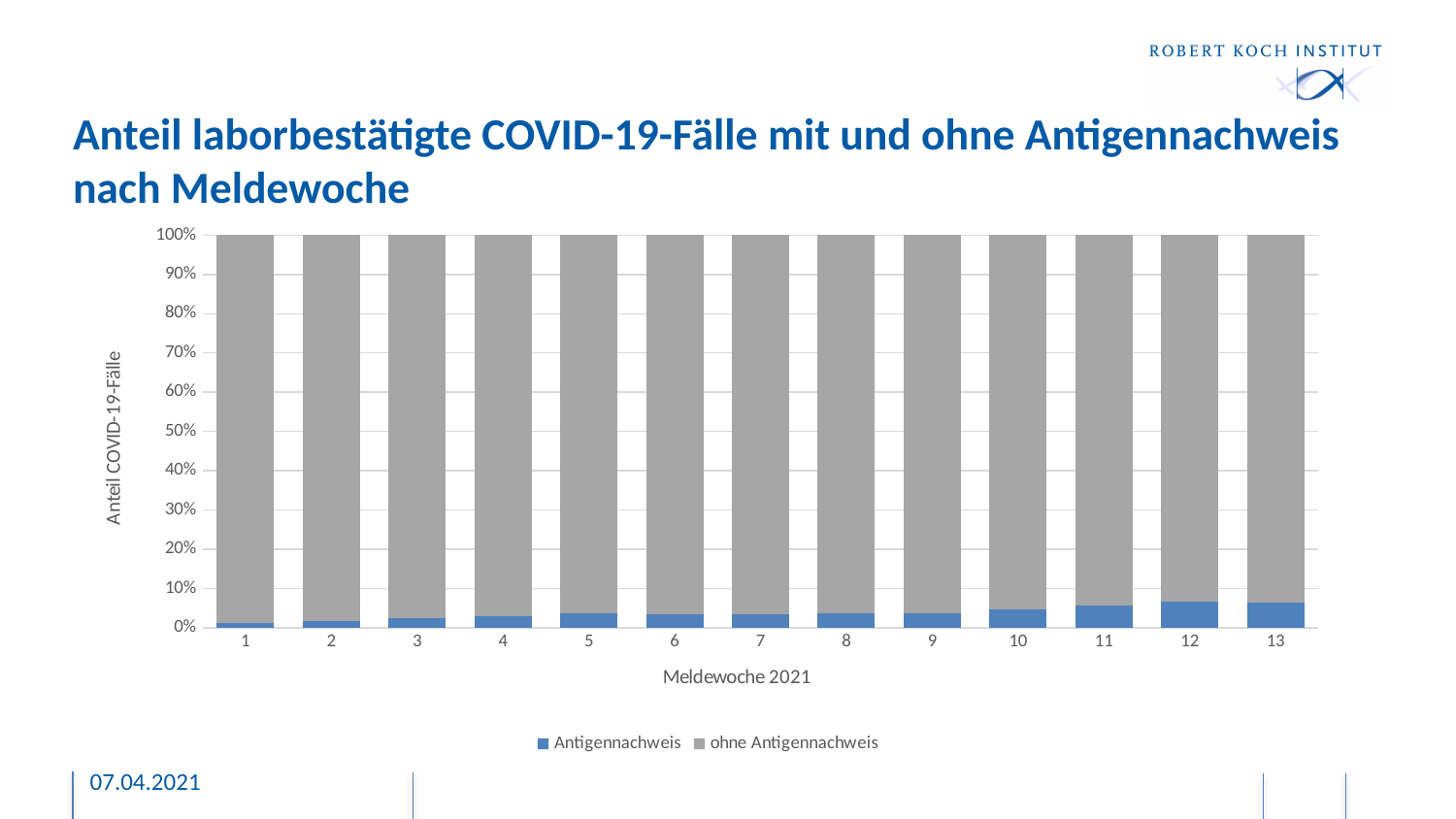
What kind of chart is shown on the slide? stacked bar chart Is the ohne Antigennachweis share in week 1 greater or less than 90%? greater Which series does the blue colour represent in the legend? Antigennachweis How many reporting weeks (Meldewochen) are shown on the x axis? 13 Is the Antigennachweis share in week 13 greater or less than 20%? less What is the label of the x axis? Meldewoche 2021 Which has the larger Antigennachweis share, week 1 or week 12? week 12 Which has the larger Antigennachweis share, week 2 or week 11? week 11 Which reporting week has the lowest share of Antigennachweis? 1 Is the Antigennachweis share in week 12 greater or less than 10%? less Does the share of Antigennachweis generally rise or fall from week 1 to week 13? rise How many series does the legend list? 2